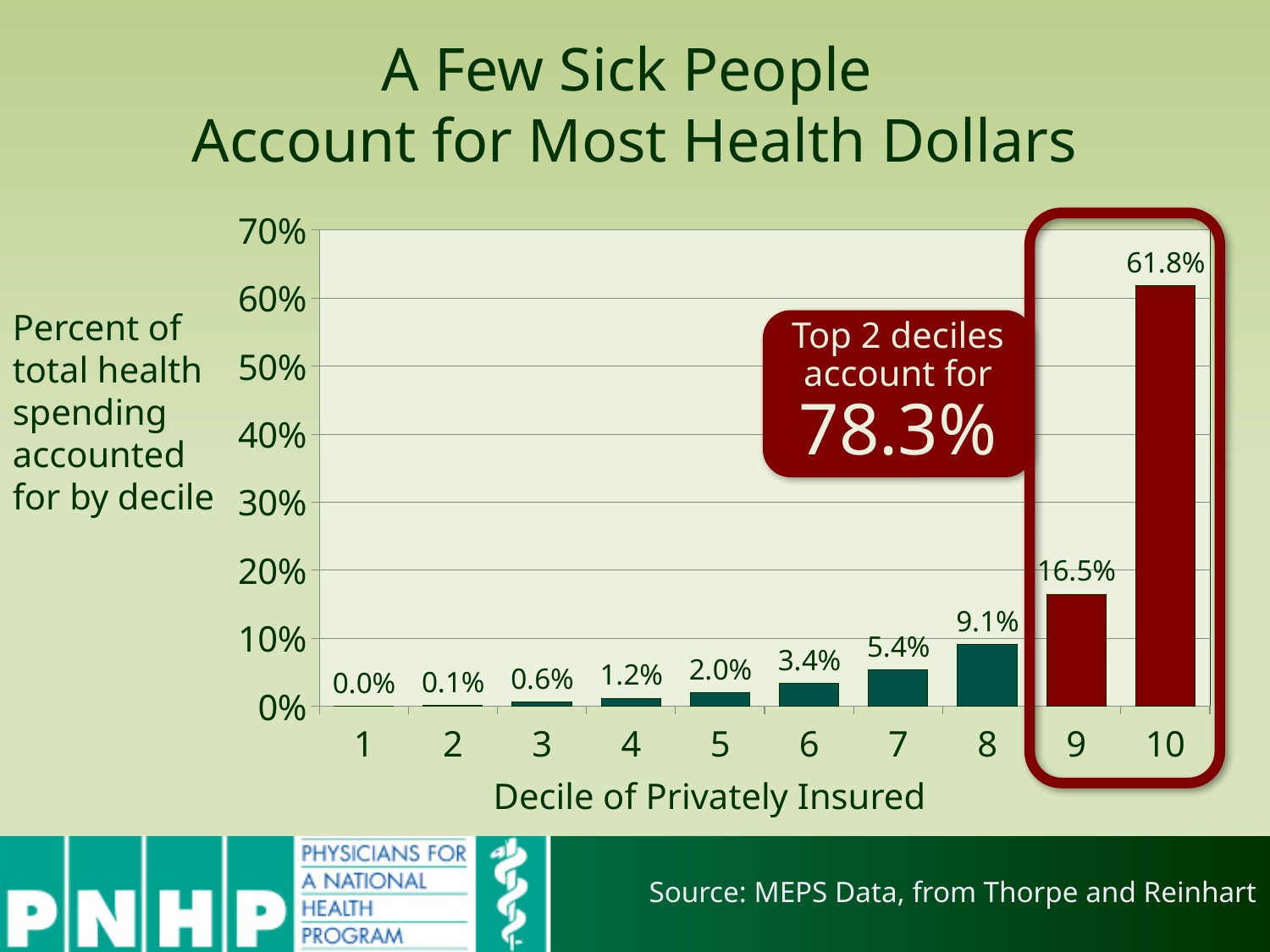
Is the value for decile 10 greater or less than 60%? greater Which has a larger value, decile 8 or decile 5? Decile 8 Which decile accounts for the highest share of total health spending? 10 How many deciles are shown on the x axis? 10 What percent of total health spending is accounted for by decile 9? 16.5% Which decile accounts for the lowest share of total health spending? 1 What is the difference between the values for decile 8 and decile 7? 3.7% What is the difference between the values for decile 10 and decile 9? 45.3% What is the value shown for decile 6? 3.4% What kind of chart is shown on the slide? Bar chart What percent of total health spending is accounted for by decile 10? 61.8% Do the values rise or fall as the decile number increases from 1 to 10? Rise